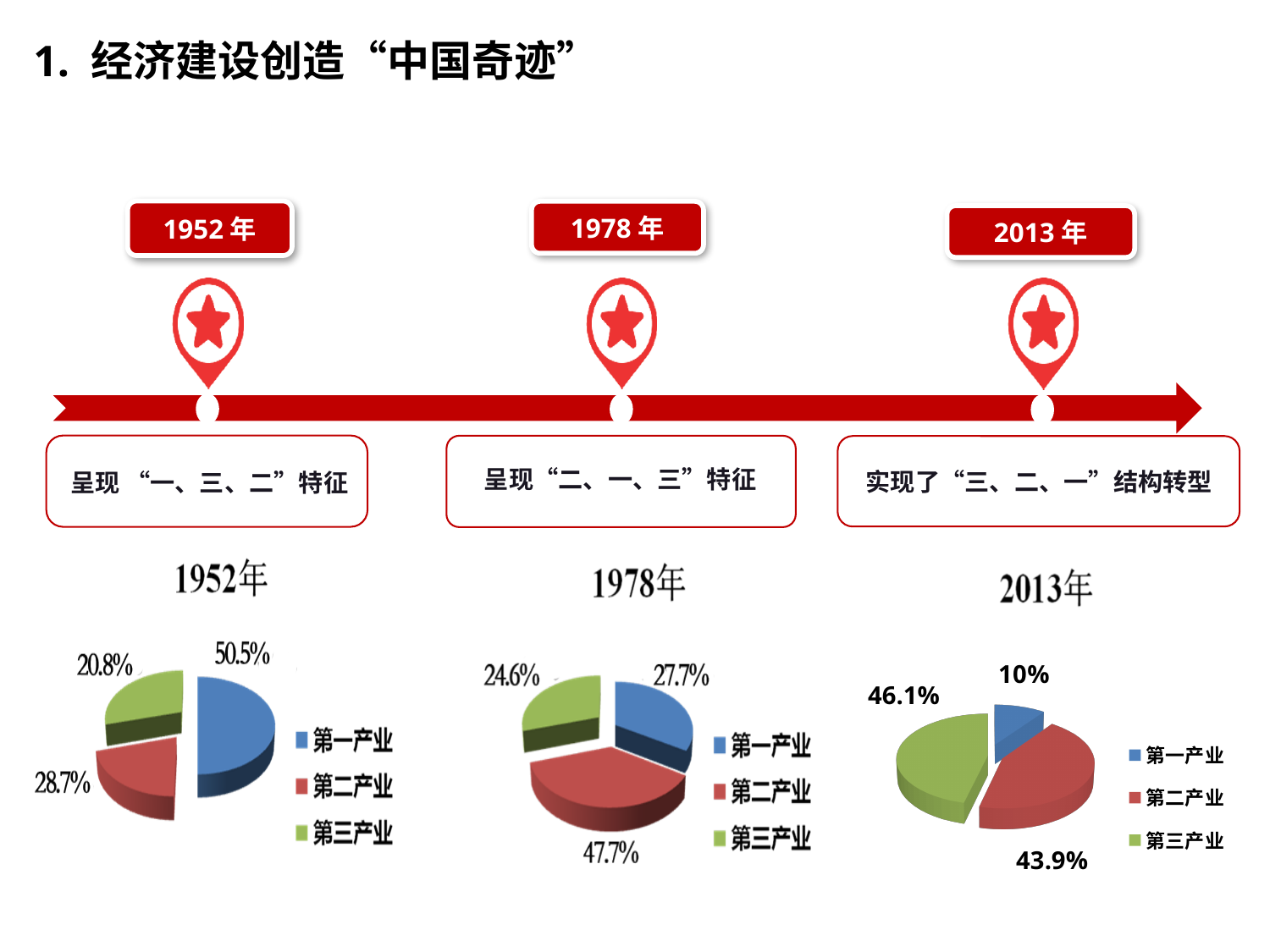
How many slices does the 1978年 pie chart have? 3 In the 2013年 pie chart, what is the difference between the shares of 第三产业 and 第二产业? 2.2% What type of chart is used for the 2013年 data? Pie chart In the 1952年 pie chart, what is the difference between the shares of 第一产业 and 第二产业? 21.8% In the 1952年 pie chart, what is the share of 第一产业? 50.5% In the 1978年 pie chart, which sector has the largest share? 第二产业 In the 1978年 pie chart, which is larger, 第一产业 or 第三产业? 第一产业 In the 2013年 pie chart, what is the share of 第一产业? 10% How many entries does the legend of the 1952年 chart list? 3 In the 1978年 pie chart, what is the share of 第二产业? 47.7% In the 2013年 pie chart, which sector has the largest share? 第三产业 In the 1952年 pie chart, which sector has the smallest share? 第三产业